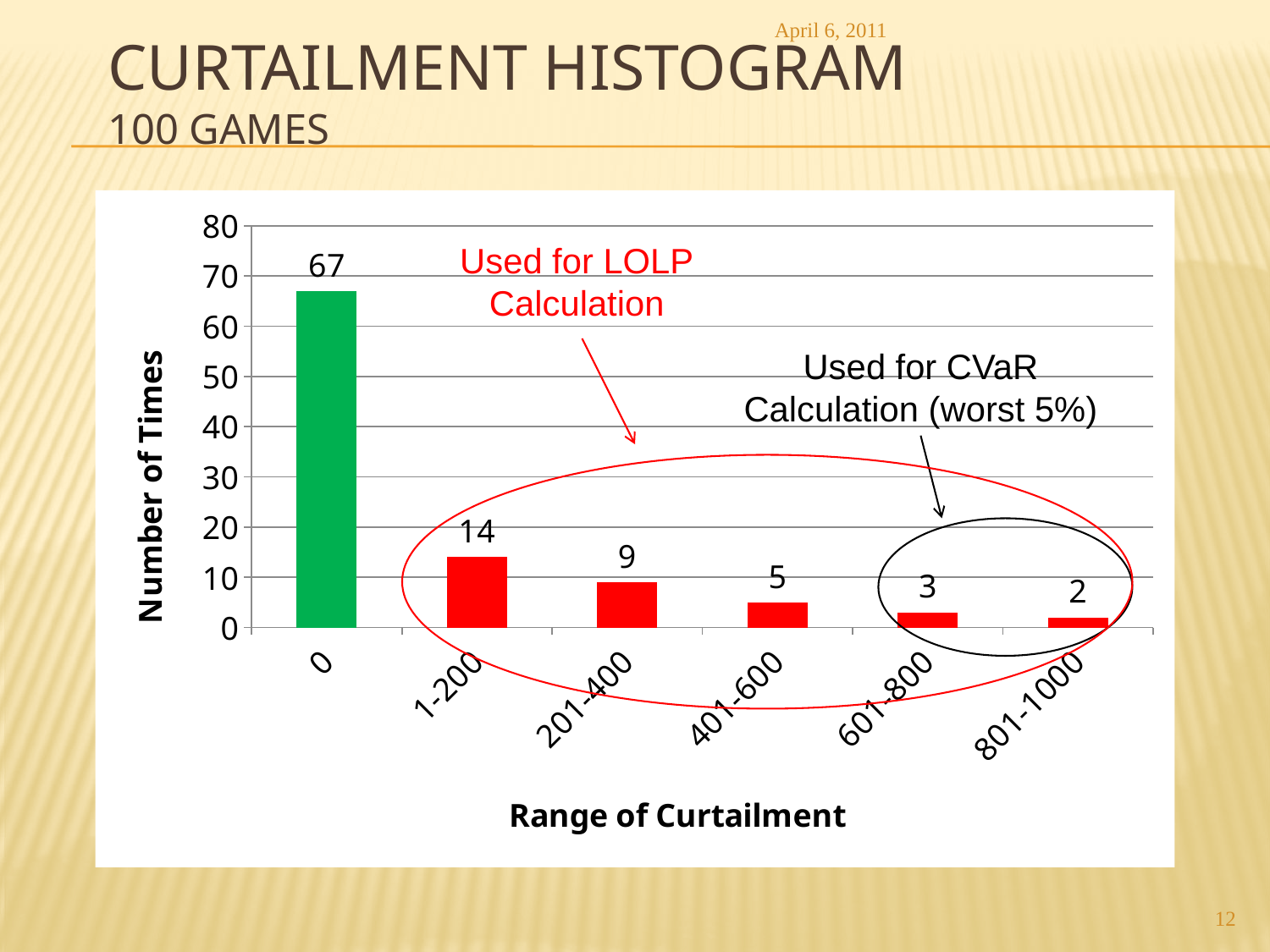
What is the number of times for the curtailment range 401-600? 5 What kind of chart is shown on the slide? bar chart What is the number of times for the curtailment range 0? 67 What is the number of times for the curtailment range 1-200? 14 Which has a larger number of times, the 601-800 range or the 401-600 range? 401-600 What is the label of the x axis? Range of Curtailment Which curtailment range has the highest number of times? 0 What is the number of times for the curtailment range 801-1000? 2 How many curtailment ranges are shown on the x axis? 6 Is the number of times for the 0 range greater or less than 60? greater Which curtailment range has the lowest number of times? 801-1000 What is the difference in number of times between the 1-200 range and the 201-400 range? 5